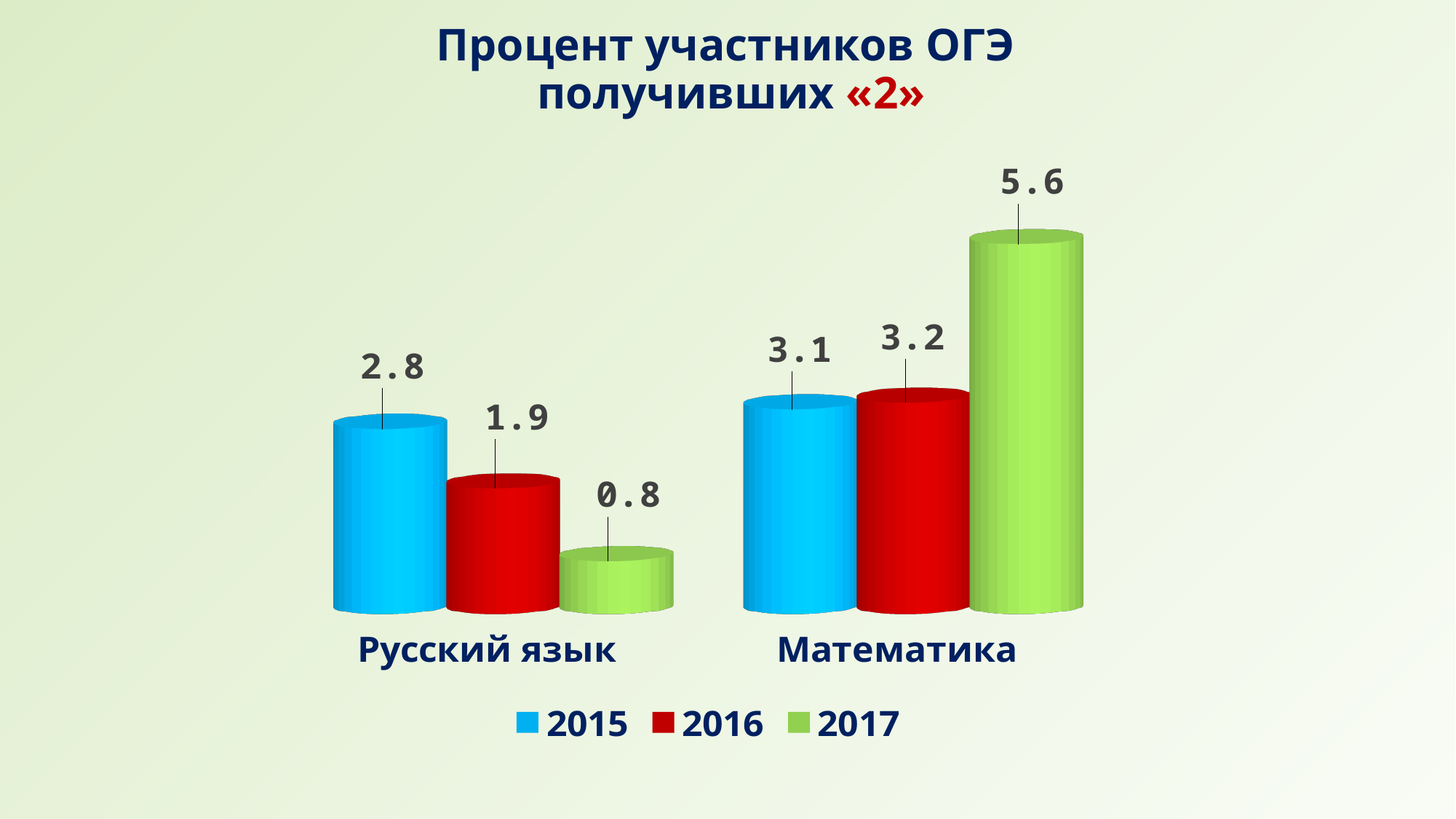
What is the value for Математика in 2017? 5.6 Which year has the lowest value for Русский язык? 2017 What is the difference between the 2017 values for Математика and Русский язык? 4.8 How many categories are shown on the x axis? 2 Which is larger: the 2015 value for Математика or the 2015 value for Русский язык? Математика What is the value for Математика in 2016? 3.2 How many series does the legend list? 3 Which category has the highest value in 2017? Математика What kind of chart is shown on the slide? Bar chart What is the value for Русский язык in 2017? 0.8 What is the difference between the 2015 and 2016 values for Русский язык? 0.9 What is the value for Русский язык in 2015? 2.8